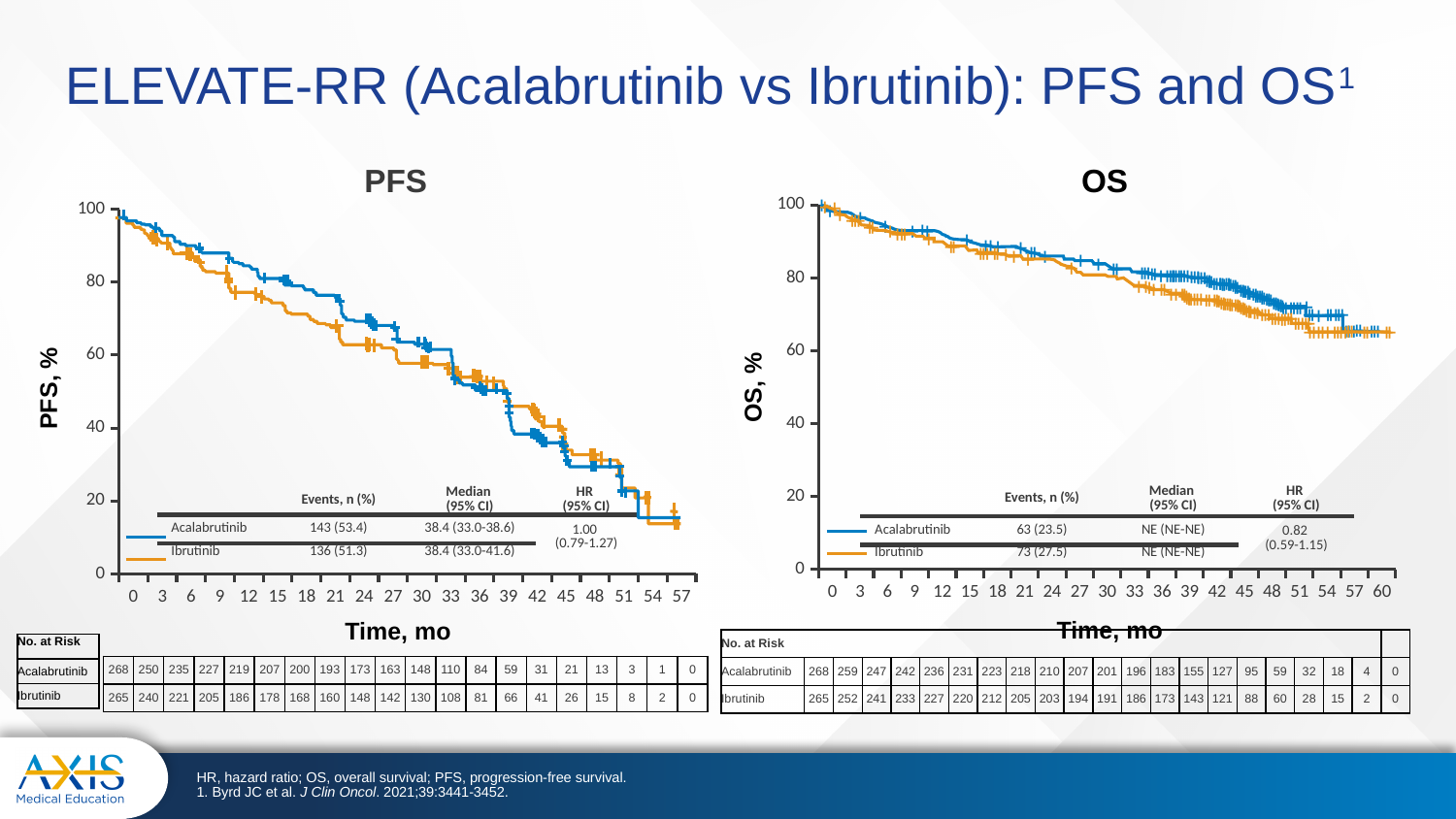
How many series does the legend of the OS chart list? 2 In the PFS chart, do the survival curves rise or fall as time increases along the x axis? fall In the PFS chart's No. at Risk table, how many Acalabrutinib patients are at risk at 24 months? 173 In the OS chart, how many events, n (%), are reported for Ibrutinib? 73 (27.5) In the OS chart, is the Acalabrutinib curve at 24 months greater or less than 80%? greater In the OS chart's No. at Risk table, what is the difference between the number of Acalabrutinib and Ibrutinib patients at risk at 0 months? 3 In the OS chart, what is the hazard ratio (95% CI) shown? 0.82 (0.59-1.15) In the OS chart, what is the median OS (95% CI) for Acalabrutinib? NE (NE-NE) What kind of chart is the PFS chart on the left? Line chart (Kaplan-Meier curve) In the PFS chart, how many events, n (%), are reported for Acalabrutinib? 143 (53.4) In the PFS chart, what is the median PFS (95% CI) for Ibrutinib? 38.4 (33.0-41.6) In the PFS chart, what is the hazard ratio (95% CI) shown? 1.00 (0.79-1.27)